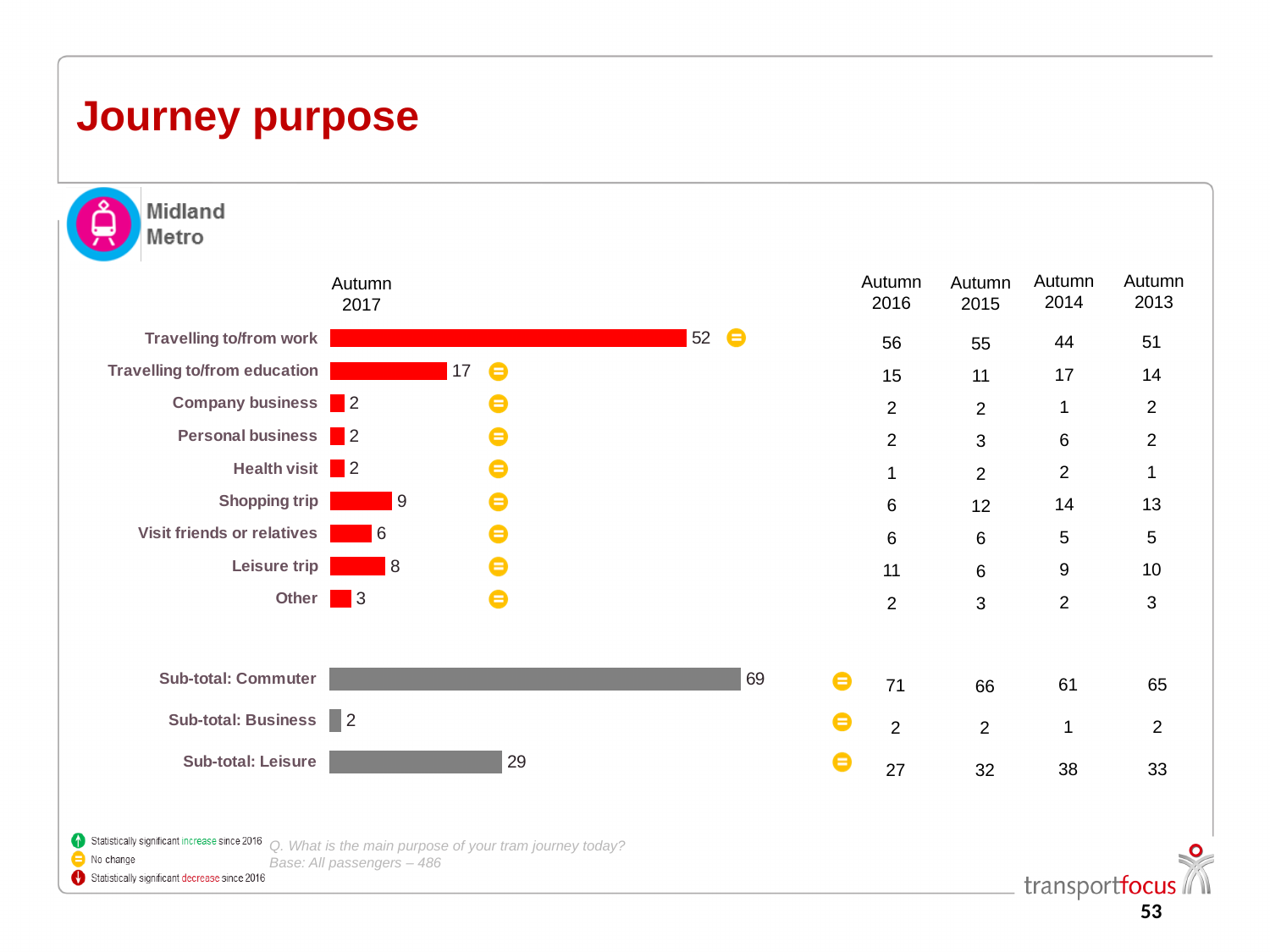
What is the Autumn 2017 value for Shopping trip? 9 Which has a larger Autumn 2017 value, Visit friends or relatives or Leisure trip? Leisure trip What is the difference between the Autumn 2017 values for Travelling to/from work and Travelling to/from education? 35 What kind of chart is used to show the Autumn 2017 values? Bar chart Which of the three sub-totals has the lowest Autumn 2017 value? Sub-total: Business Which journey purpose has the highest Autumn 2017 value? Travelling to/from work What is the Autumn 2017 value for Sub-total: Leisure? 29 What is the title of the slide? Journey purpose How many individual journey purpose categories (excluding sub-totals) are plotted for Autumn 2017? 9 What is the Autumn 2017 value for Travelling to/from work? 52 What is the difference between the Autumn 2017 values for Sub-total: Commuter and Sub-total: Leisure? 40 Which has a larger Autumn 2017 value, Shopping trip or Leisure trip? Shopping trip